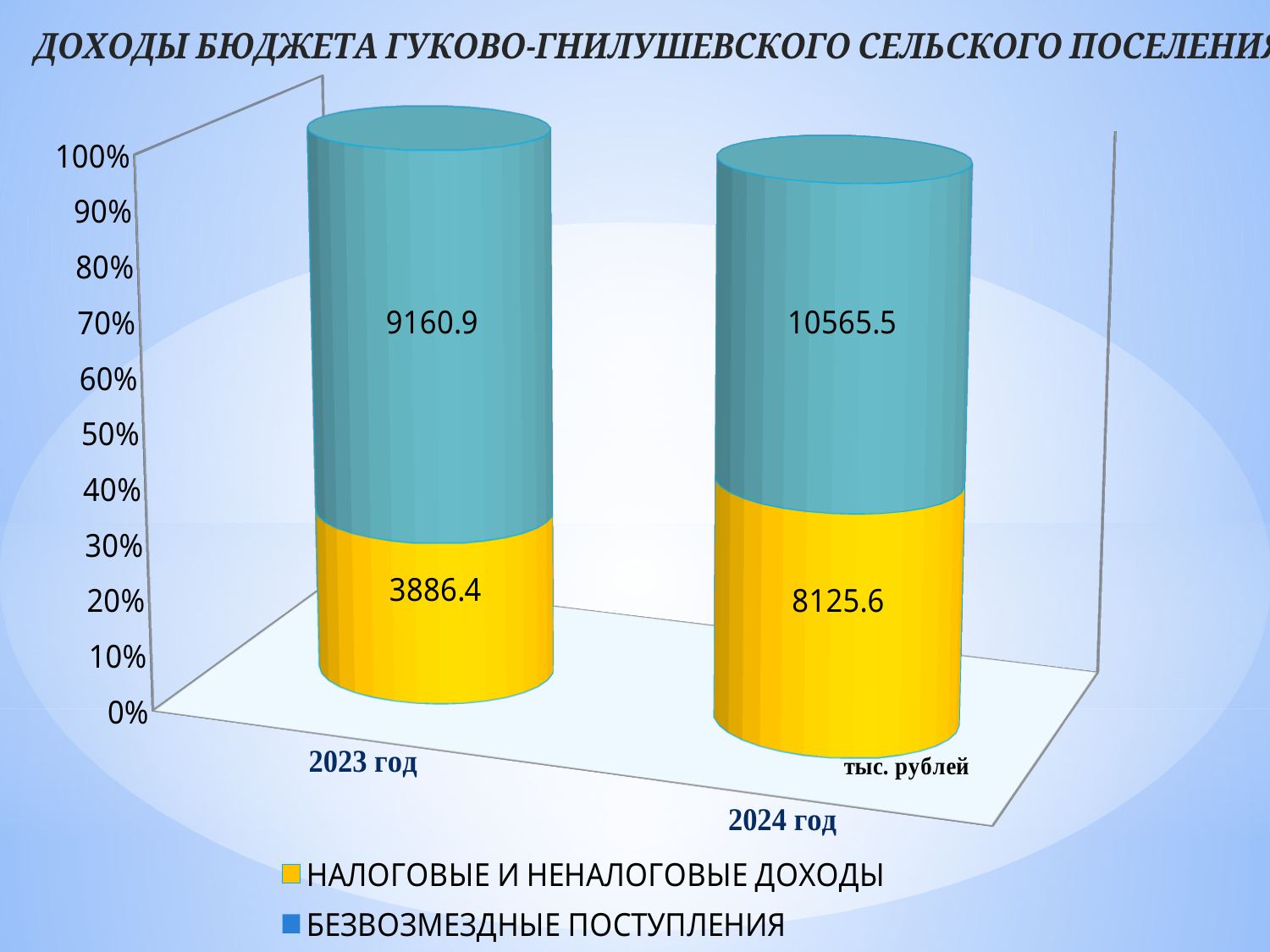
What is the value of НАЛОГОВЫЕ И НЕНАЛОГОВЫЕ ДОХОДЫ for 2024 год? 8125.6 Which year has the larger value for БЕЗВОЗМЕЗДНЫЕ ПОСТУПЛЕНИЯ, 2023 год or 2024 год? 2024 год How many categories (years) are shown on the x axis? 2 What kind of chart is shown on the slide? Stacked bar chart How many series does the legend list? 2 What is the total of the stacked bar for 2023 год? 13047.3 By how much did НАЛОГОВЫЕ И НЕНАЛОГОВЫЕ ДОХОДЫ increase from 2023 год to 2024 год? 4239.2 What is the value of БЕЗВОЗМЕЗДНЫЕ ПОСТУПЛЕНИЯ for 2024 год? 10565.5 What is the total of the stacked bar for 2024 год? 18691.1 What is the value of БЕЗВОЗМЕЗДНЫЕ ПОСТУПЛЕНИЯ for 2023 год? 9160.9 What is the value of НАЛОГОВЫЕ И НЕНАЛОГОВЫЕ ДОХОДЫ for 2023 год? 3886.4 What is the difference between БЕЗВОЗМЕЗДНЫЕ ПОСТУПЛЕНИЯ and НАЛОГОВЫЕ И НЕНАЛОГОВЫЕ ДОХОДЫ in 2023 год? 5274.5